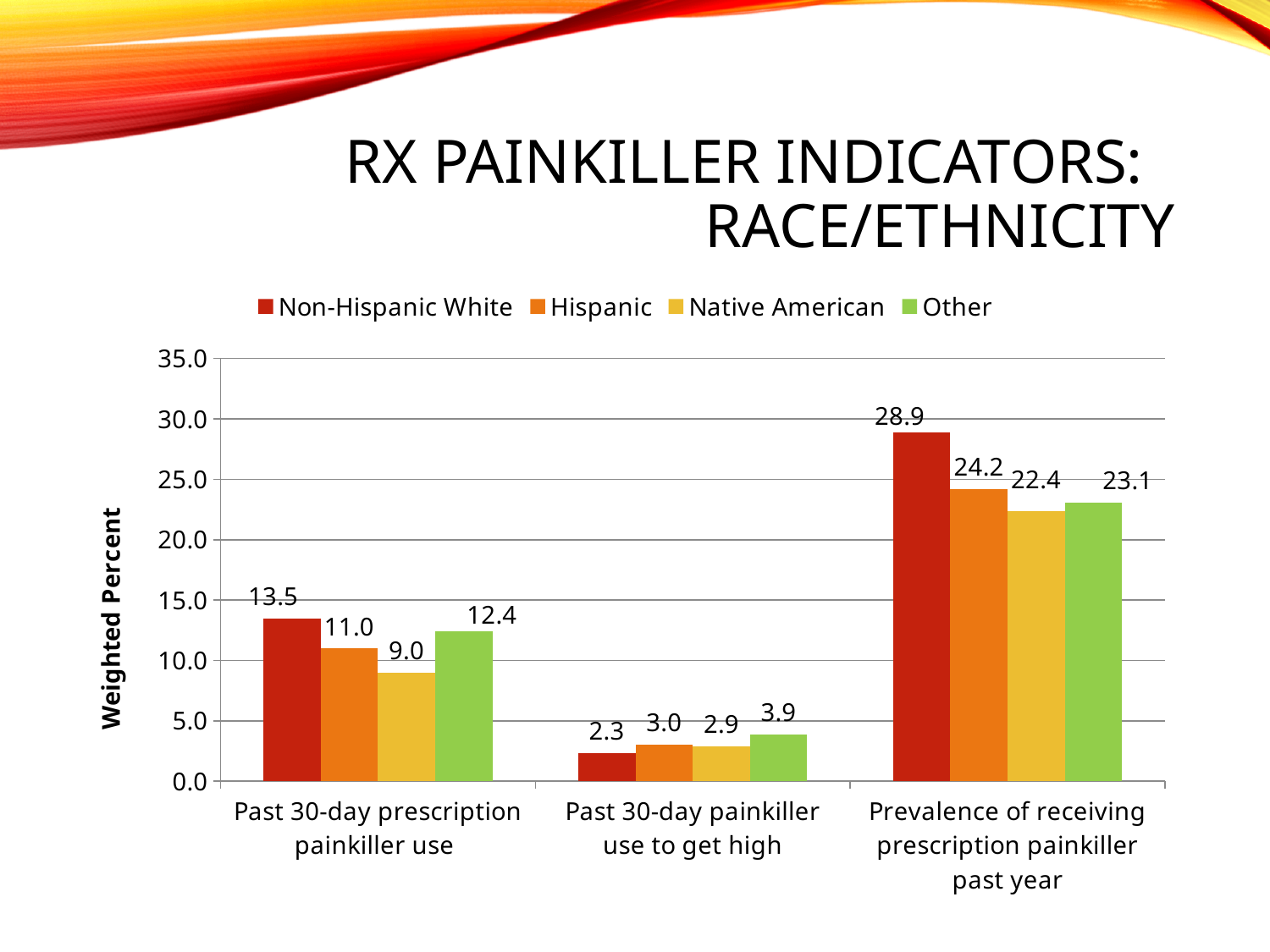
How many categories are shown on the x axis? 3 What is the difference between the Non-Hispanic White and Hispanic values in the 'Prevalence of receiving prescription painkiller past year' category? 4.7 What is the value for Other in the 'Past 30-day painkiller use to get high' category? 3.9 What kind of chart is shown on the slide? bar chart Which is larger in the 'Past 30-day prescription painkiller use' category: Hispanic or Other? Other How many series does the legend list? 4 What is the value for Native American in the 'Prevalence of receiving prescription painkiller past year' category? 22.4 Is the value for Hispanic in the 'Prevalence of receiving prescription painkiller past year' category greater or less than 20.0? greater Which series has the lowest value in the 'Past 30-day prescription painkiller use' category? Native American What is the value for Non-Hispanic White in the 'Past 30-day prescription painkiller use' category? 13.5 What is the label of the vertical axis? Weighted Percent Which series has the highest value in the 'Prevalence of receiving prescription painkiller past year' category? Non-Hispanic White